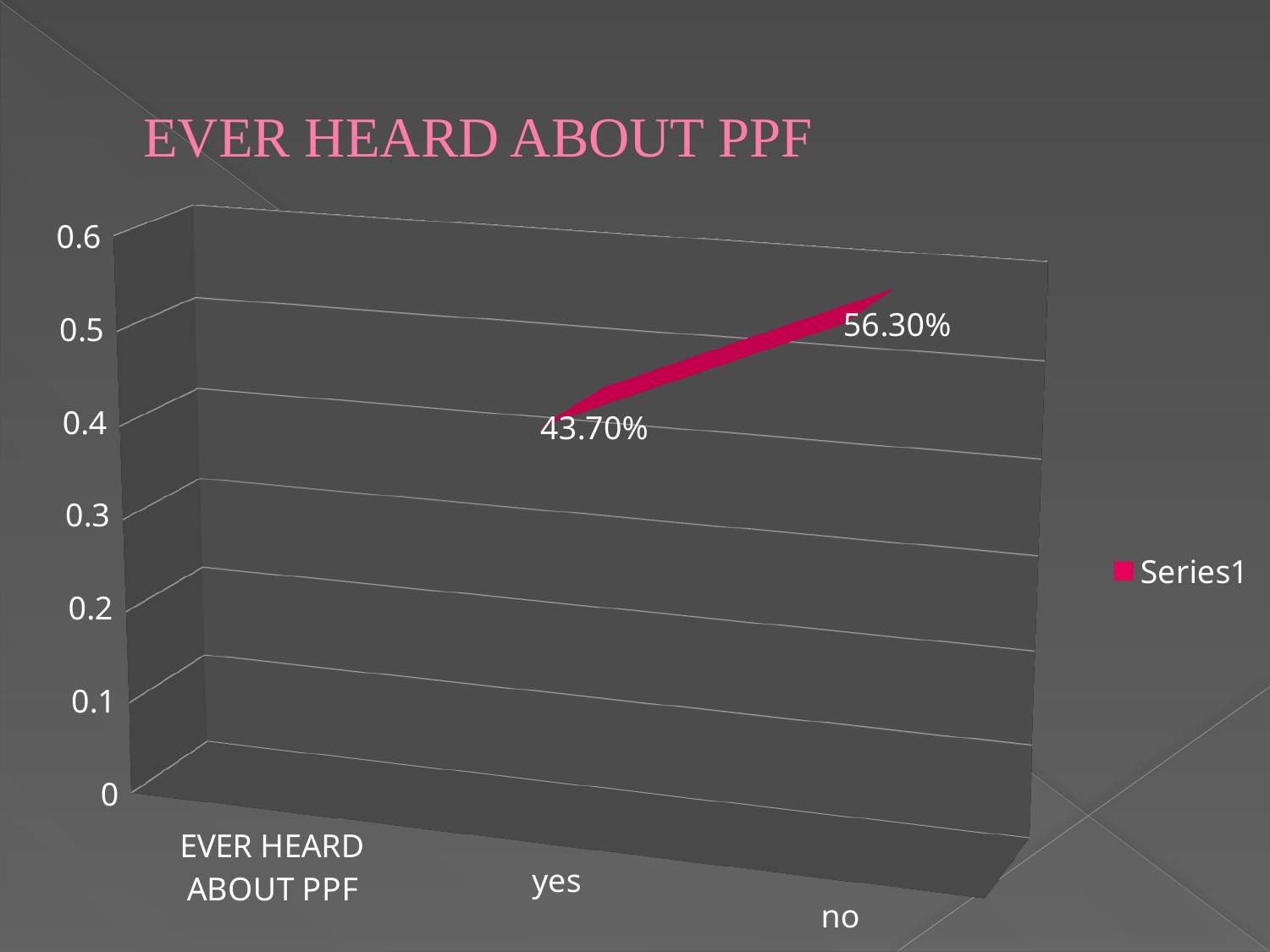
Which category has the lowest labelled value? yes What is the value for "no"? 56.30% What is the difference between the values for "no" and "yes"? 12.60% What is the value for "yes"? 43.70% What is the title of the chart? EVER HEARD ABOUT PPF What kind of chart is shown on the slide? line chart Is the value for "yes" greater or less than 0.5? less What is the name of the series shown in the legend? Series1 Which category has the highest value? no Which is larger, the value for "yes" or the value for "no"? no Is the value for "no" greater or less than 0.5? greater How many series does the legend list? 1